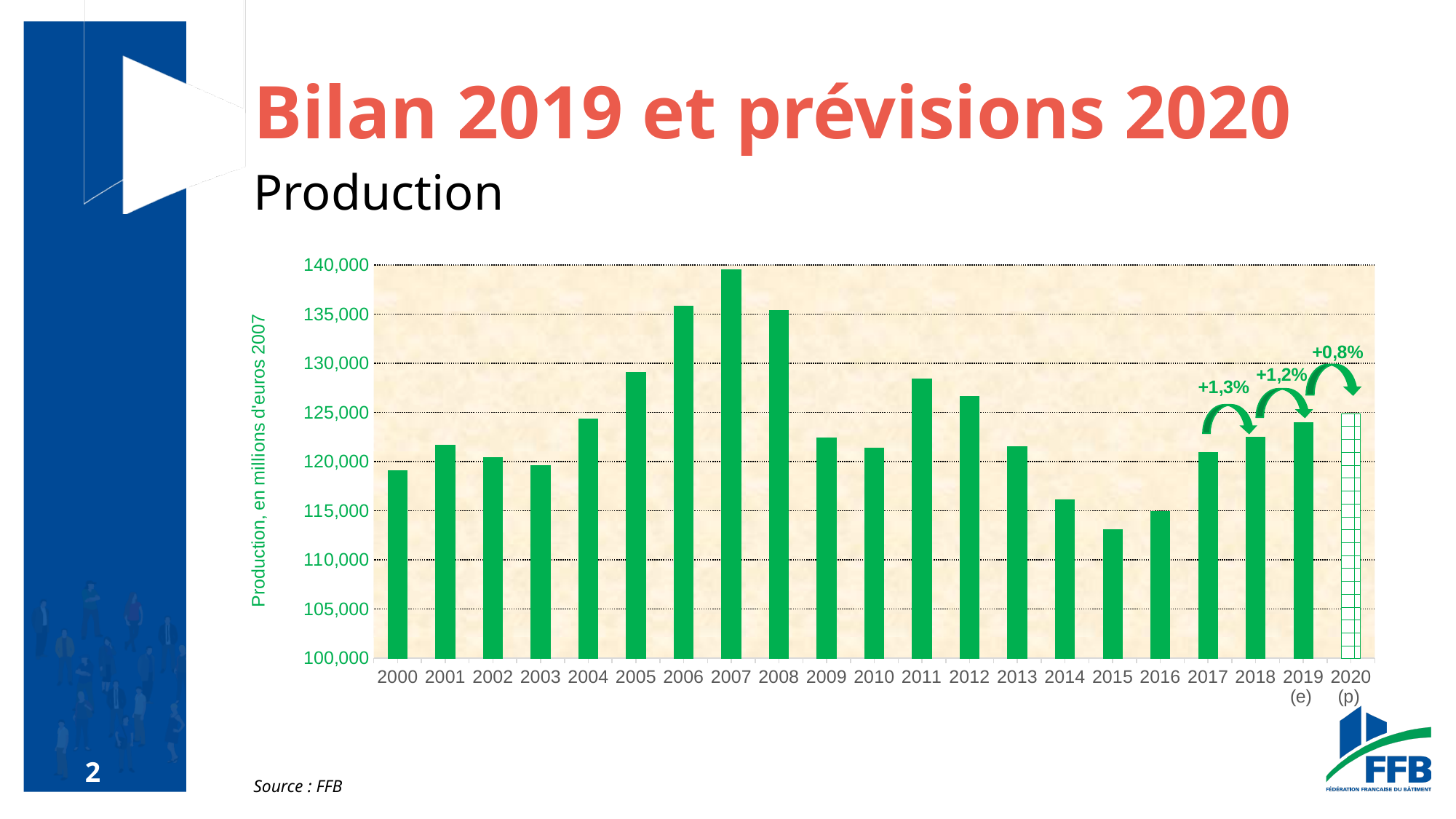
Is the production value for 2015 greater or less than 115,000? less Is the production value for 2000 greater or less than 120,000? less Which year has the larger production value, 2005 or 2013? 2005 Do the production values rise or fall from 2007 to 2015? fall What percentage change is annotated between 2019 (e) and 2020 (p)? +0,8% Is the production value for 2011 greater or less than 125,000? greater Which year has the highest production value? 2007 What kind of chart is shown on the slide? bar chart What is the label of the vertical axis? Production, en millions d'euros 2007 How many years (bars) are plotted on the chart? 21 Which year has the lowest production value? 2015